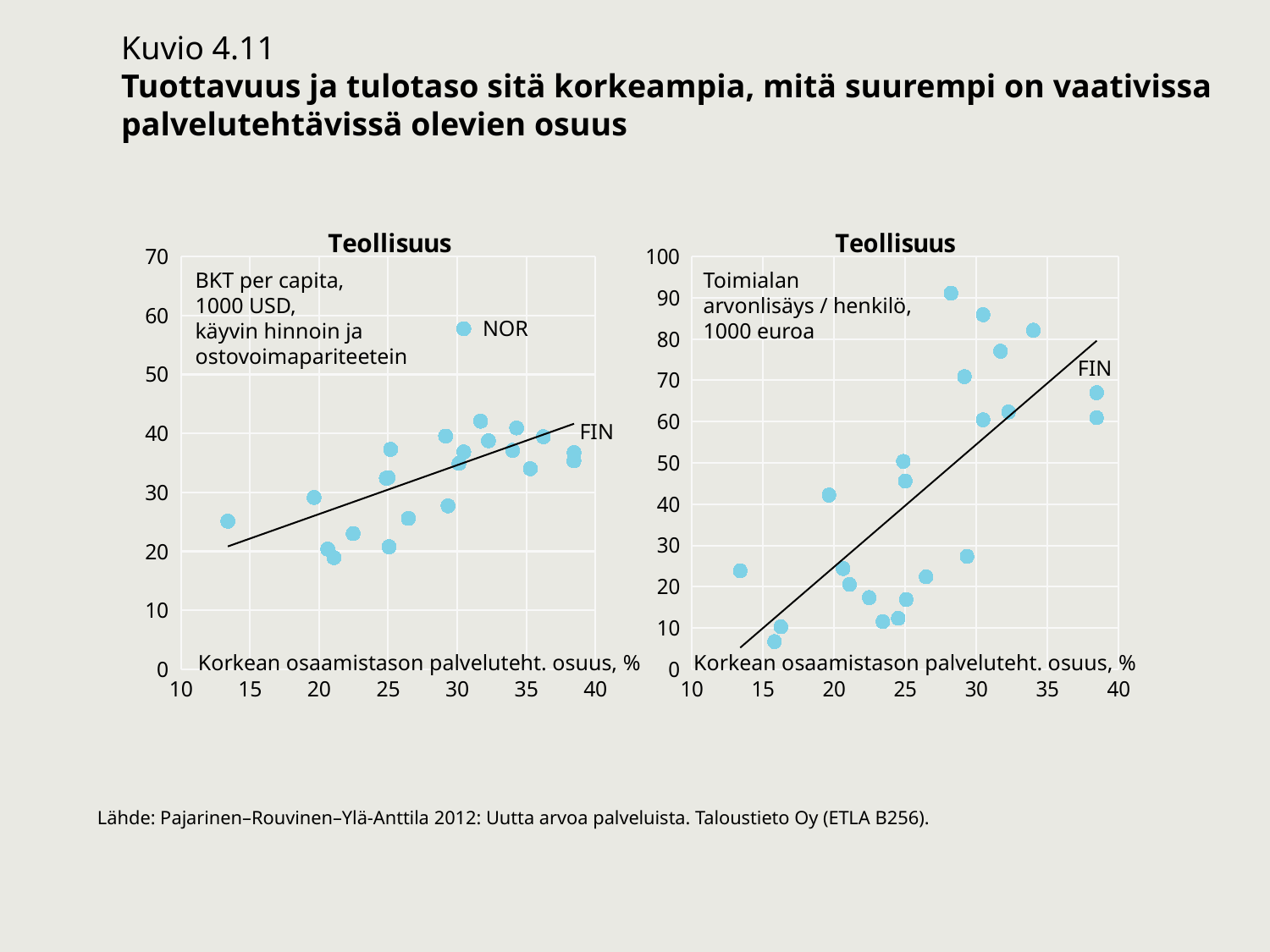
In the left chart (BKT per capita), does the fitted line rise or fall as the share of high-skill service jobs increases? rises In the left chart (BKT per capita), is the value for NOR greater or less than 50? greater What quantity is plotted on the y axis of the right chart? Toimialan arvonlisäys / henkilö, 1000 euroa In the right chart (Toimialan arvonlisäys / henkilö), does the fitted line rise or fall along the x axis? rises What kind of chart is the right chart titled Teollisuus? scatter chart In the left chart (BKT per capita), which labeled point has the highest value? NOR In the right chart (Toimialan arvonlisäys / henkilö), is the value for FIN greater or less than 50? greater What is the x-axis label of the left chart? Korkean osaamistason palveluteht. osuus, % In the left chart (BKT per capita), is the value for FIN greater or less than 30? greater In the left chart (BKT per capita), which labeled point has the larger value, NOR or FIN? NOR What kind of chart is the left chart titled Teollisuus? scatter chart